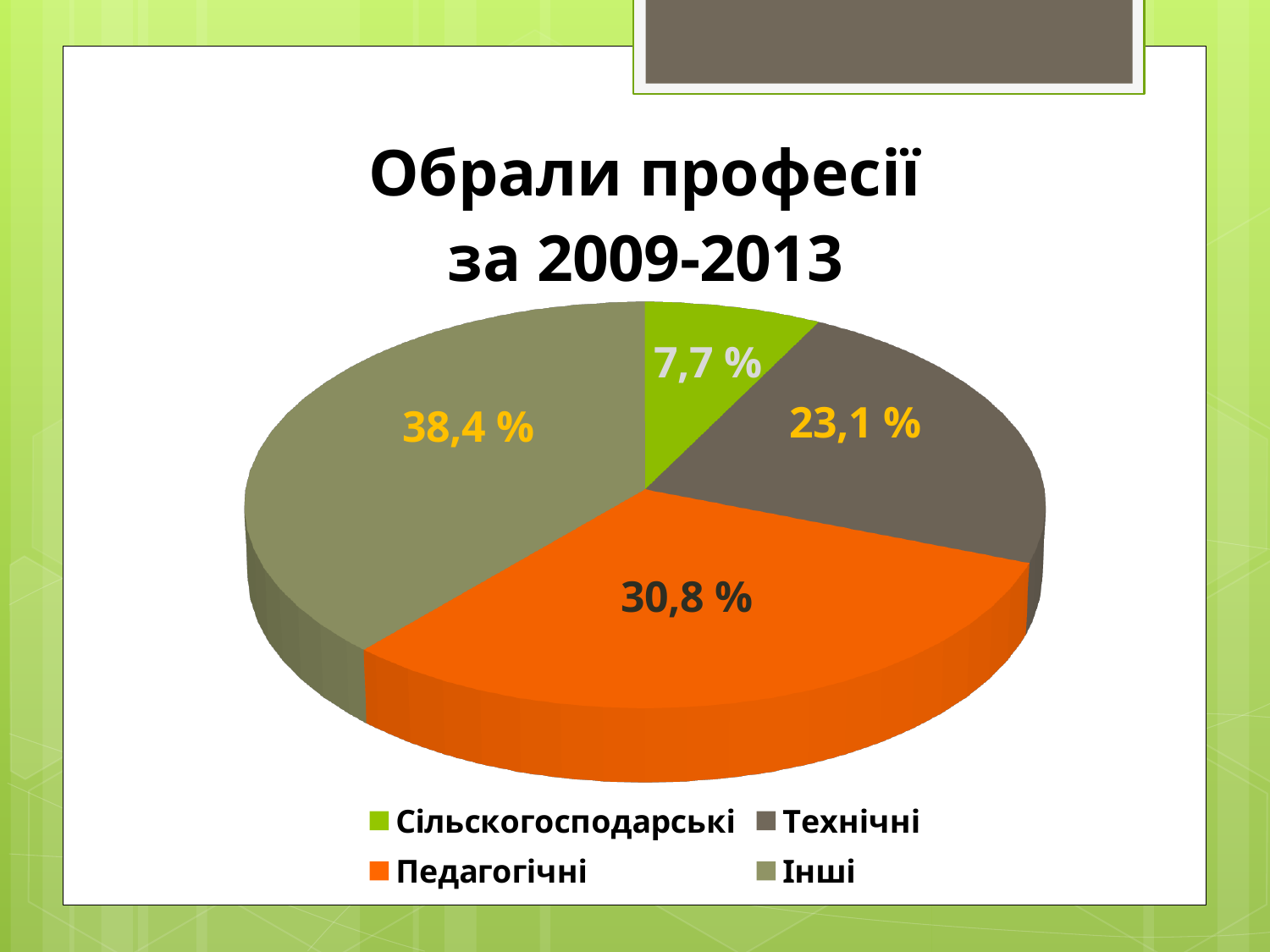
What is the difference between the values for Інші and Педагогічні? 7,6 % Which is larger, the value for Педагогічні or the value for Технічні? Педагогічні What is the value for Технічні? 23,1 % Which category has the smallest share of the pie? Сільскогосподарські Which category has the largest share of the pie? Інші What is the difference between the values for Технічні and Сільскогосподарські? 15,4 % What is the value for Інші? 38,4 % What is the title of the chart? Обрали професії за 2009-2013 What is the value for Сільскогосподарські? 7,7 % How many categories does the pie chart have? 4 What kind of chart is shown on the slide? Pie chart What is the value for Педагогічні? 30,8 %